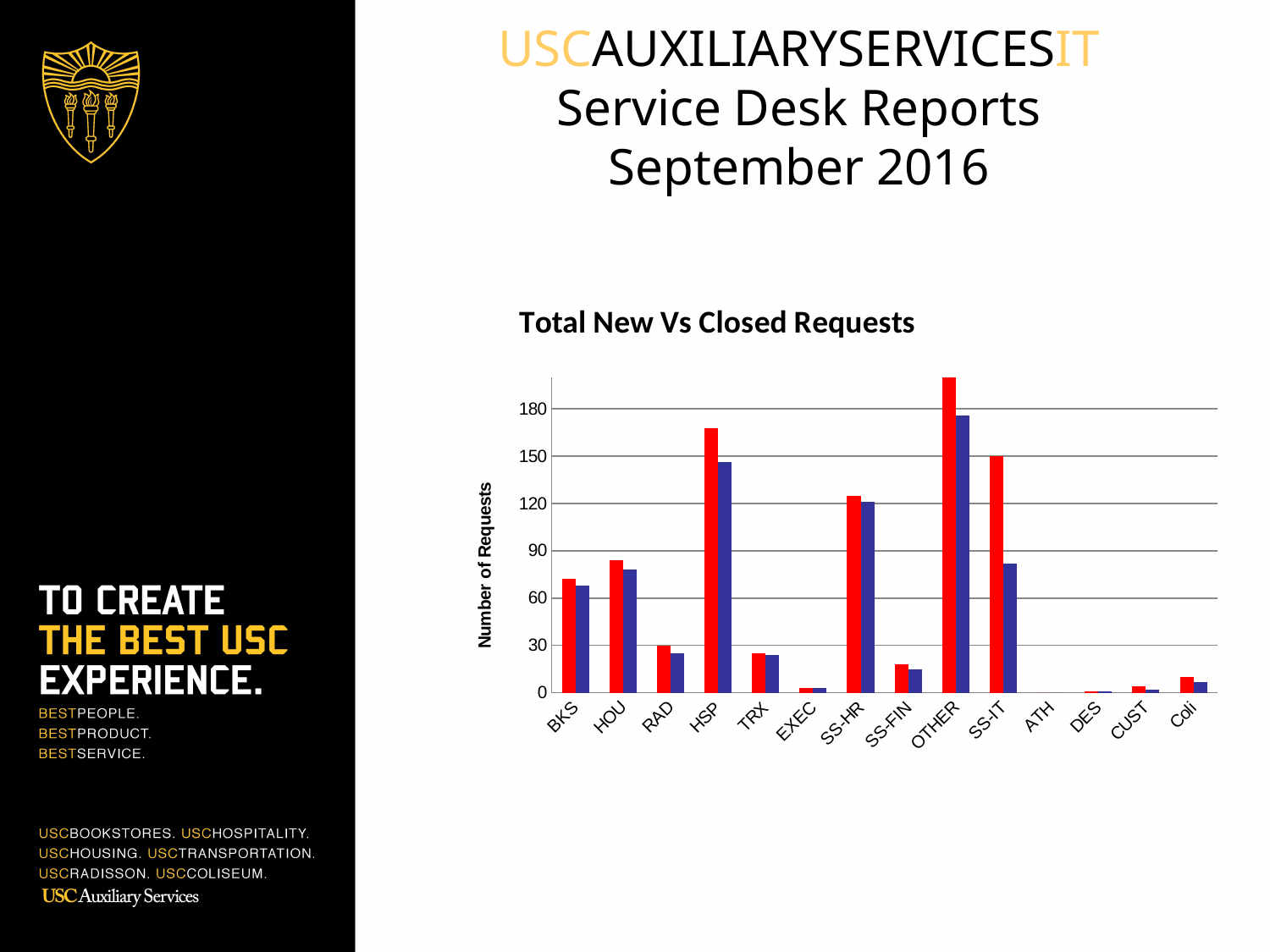
Which category has the taller red bar, HSP or SS-HR? HSP Is the red bar for HSP greater or less than 150? greater Is the red bar for OTHER greater or less than 180? greater Which category has the lowest bars in the chart? ATH For SS-IT, which bar is taller, the red bar or the blue bar? the red bar What kind of chart is shown on the slide? bar chart Which category has the tallest bar in the chart? OTHER Is the red bar for TRX greater or less than 30? less What is the title of the chart? Total New Vs Closed Requests How many categories are shown along the x axis of the chart? 14 What is the label on the vertical axis of the chart? Number of Requests